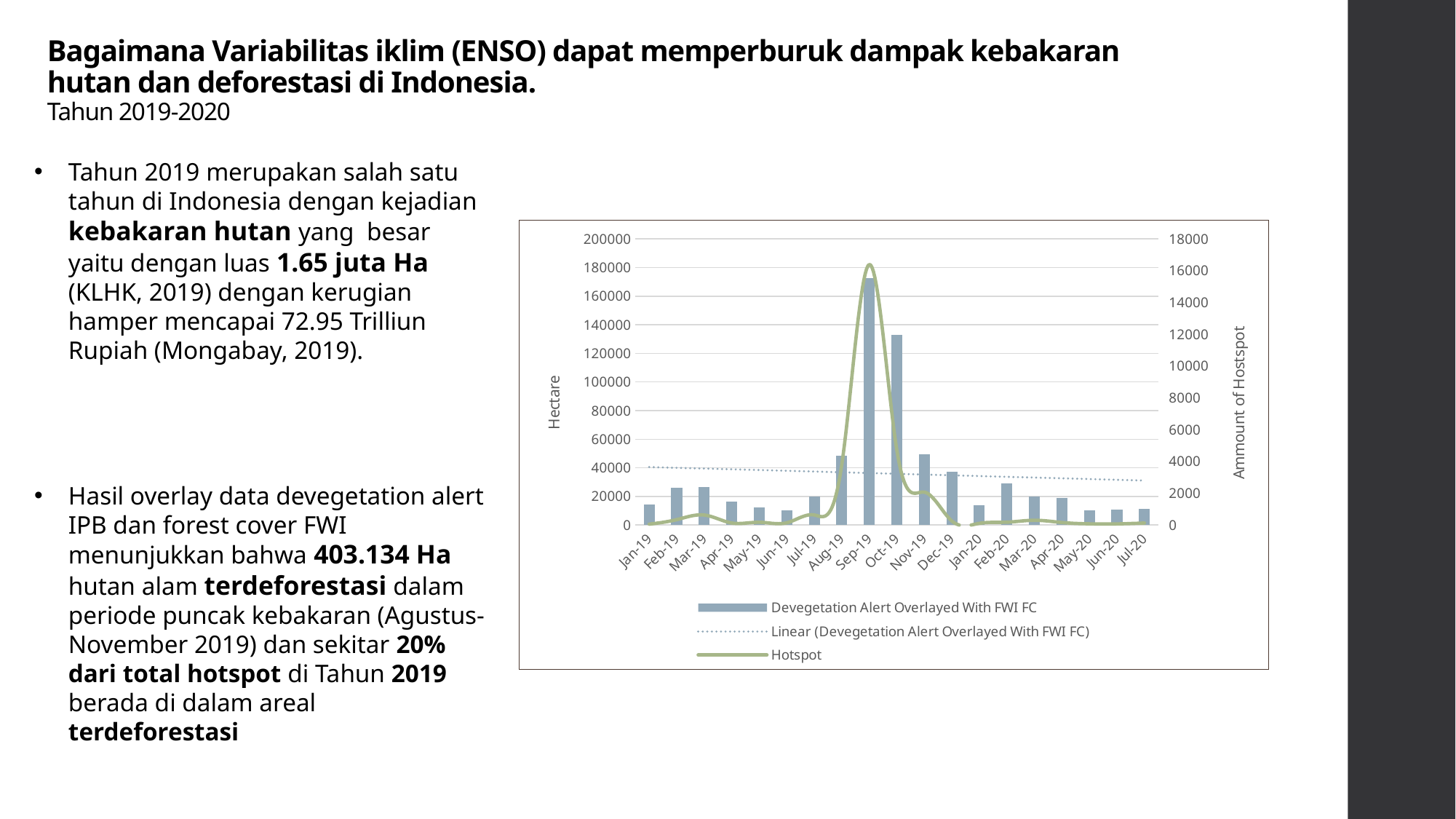
What is the label of the left vertical axis of the chart? Hectare How many months are shown along the x axis of the chart? 19 Is the Hotspot value for Sep-19 greater or less than 14000? greater How many series does the chart legend list? 3 What is the label of the right vertical axis of the chart? Ammount of Hotspot Does the Linear (Devegetation Alert Overlayed With FWI FC) trendline rise or fall from Jan-19 to Jul-20? fall In which month is the Devegetation Alert Overlayed With FWI FC bar the highest? Sep-19 Is the Devegetation Alert Overlayed With FWI FC value for Sep-19 greater or less than 160000? greater Is the Devegetation Alert Overlayed With FWI FC value for Oct-19 greater or less than 120000? greater Which month has the larger Devegetation Alert Overlayed With FWI FC bar, Sep-19 or Oct-19? Sep-19 What kind of chart is shown on the slide? A combined bar and line chart